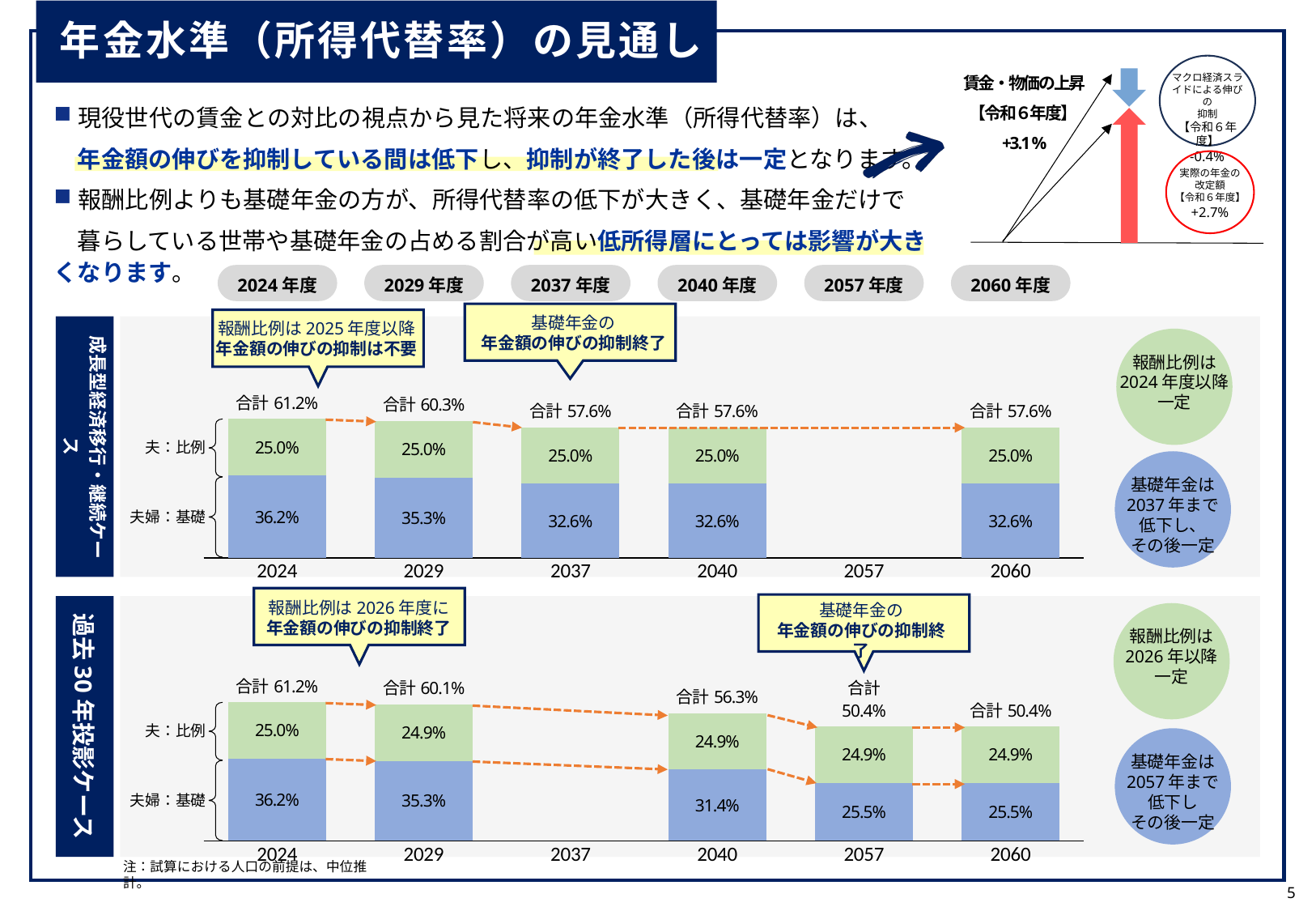
過去30年投影ケースのグラフで、合計は2024年から2060年にかけて上昇していますか、低下していますか？ 低下 過去30年投影ケースのグラフで、2057年の夫婦：基礎の値はいくらですか？ 25.5% このスライドのグラフはどの種類のグラフですか？ 積み上げ棒グラフ 成長型経済移行・継続ケースのグラフで、2037年の合計はいくらですか？ 57.6% 2040年の夫婦：基礎の値は、成長型経済移行・継続ケースと過去30年投影ケースのどちらが大きいですか？ 成長型経済移行・継続ケース 過去30年投影ケースのグラフで、2024年と2060年の合計の差はいくらですか？ 10.8ポイント 過去30年投影ケースのグラフで、2040年の夫：比例の値はいくらですか？ 24.9% 成長型経済移行・継続ケースのグラフで、2024年の夫婦：基礎の値はいくらですか？ 36.2% 過去30年投影ケースのグラフで、合計が最も低い年はどれですか？ 2057年と2060年（50.4%） 成長型経済移行・継続ケースのグラフで、合計が最も高い年はどれですか？ 2024年 成長型経済移行・継続ケースのグラフで、2024年と2029年の夫婦：基礎の差はいくらですか？ 0.9ポイント 成長型経済移行・継続ケースのグラフには、棒が何本ありますか？ 5本